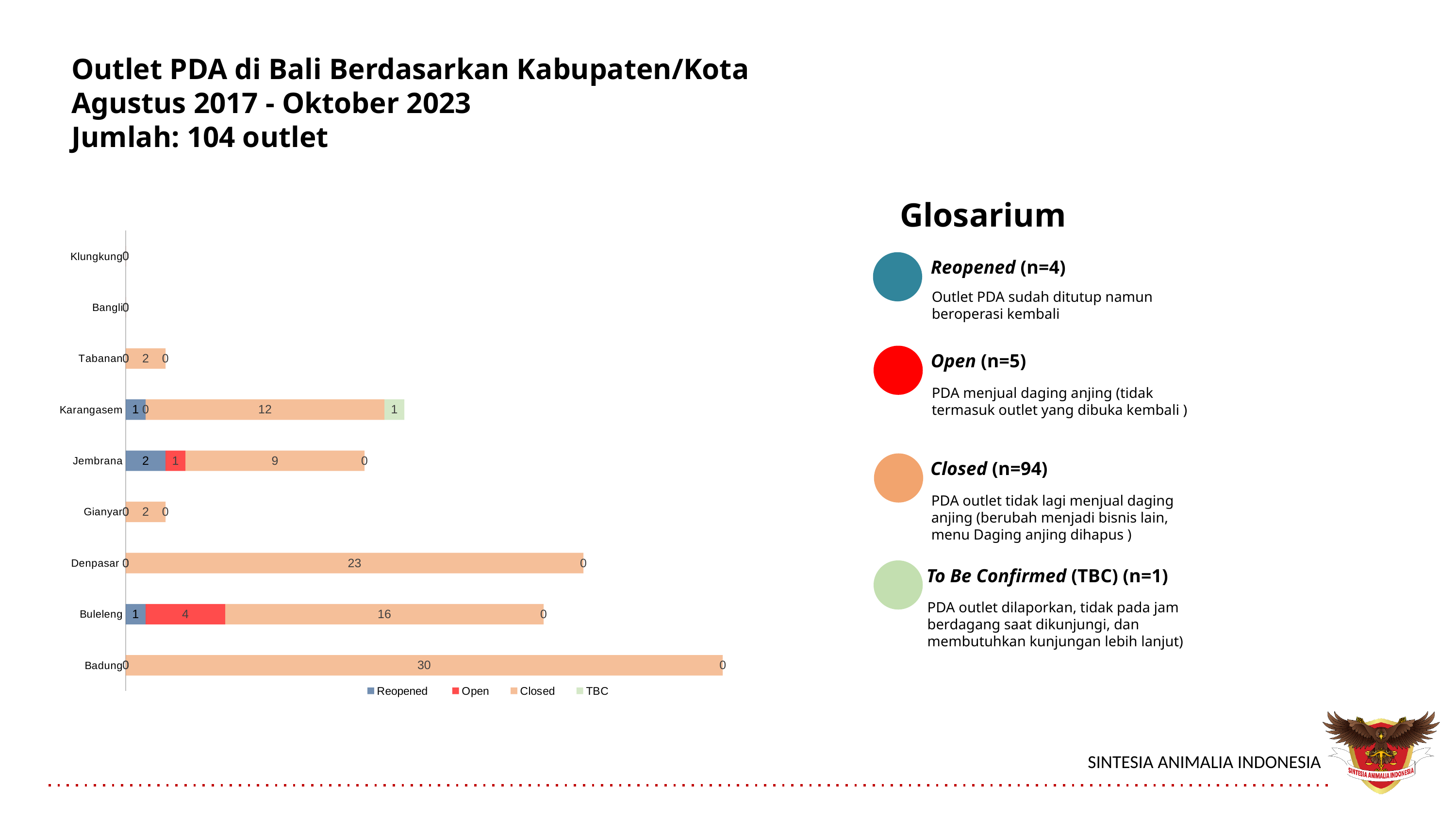
What is the difference between the Closed values for Badung and Denpasar? 7 What is the Open value for Buleleng? 4 Which is larger, the Closed value for Karangasem or the Closed value for Jembrana? Karangasem How many series does the chart legend list? 4 What is the total of the stacked bar for Buleleng? 21 How many kabupaten/kota categories are shown on the chart? 9 What is the TBC value for Karangasem? 1 What is the Closed value for Badung? 30 Which kabupaten/kota has the highest Closed value? Badung What kind of chart is shown on the slide? Stacked bar chart What is the Closed value for Denpasar? 23 What is the Reopened value for Jembrana? 2